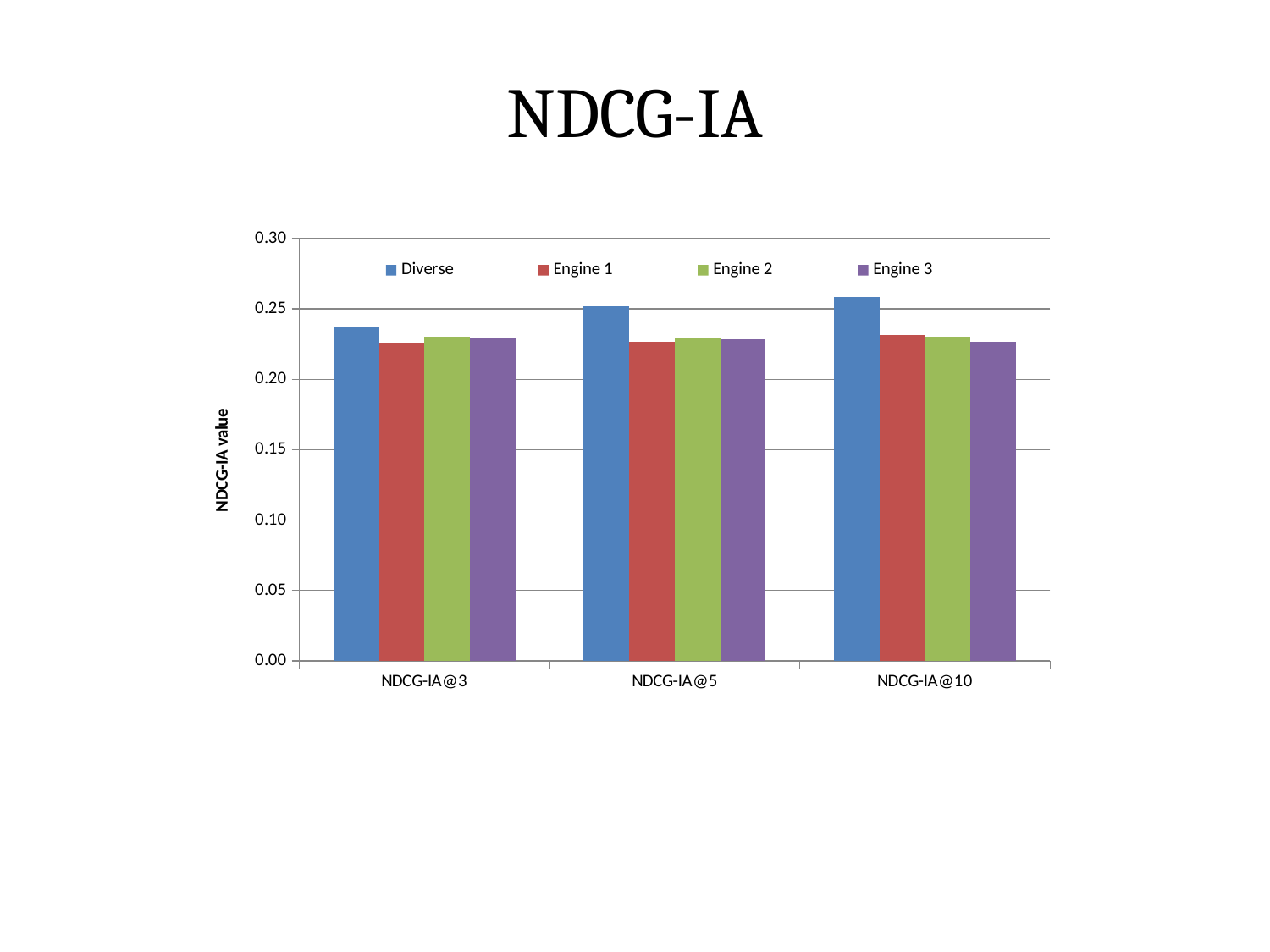
Is the value for Engine 1 at NDCG-IA@5 greater or less than 0.20? greater Which series has the lowest value for NDCG-IA@3? Engine 1 How many series does the legend list? 4 Which is larger at NDCG-IA@3: Diverse or Engine 1? Diverse Which series has the highest value for NDCG-IA@5? Diverse What is the label of the y axis? NDCG-IA value How many categories are shown on the x axis? 3 Do the values for Diverse rise or fall from NDCG-IA@3 to NDCG-IA@10? rise Which series has the highest value for NDCG-IA@10? Diverse Is the value for Diverse at NDCG-IA@3 greater or less than 0.25? less Is the value for Diverse at NDCG-IA@10 greater or less than 0.25? greater What type of chart is shown on the slide? bar chart